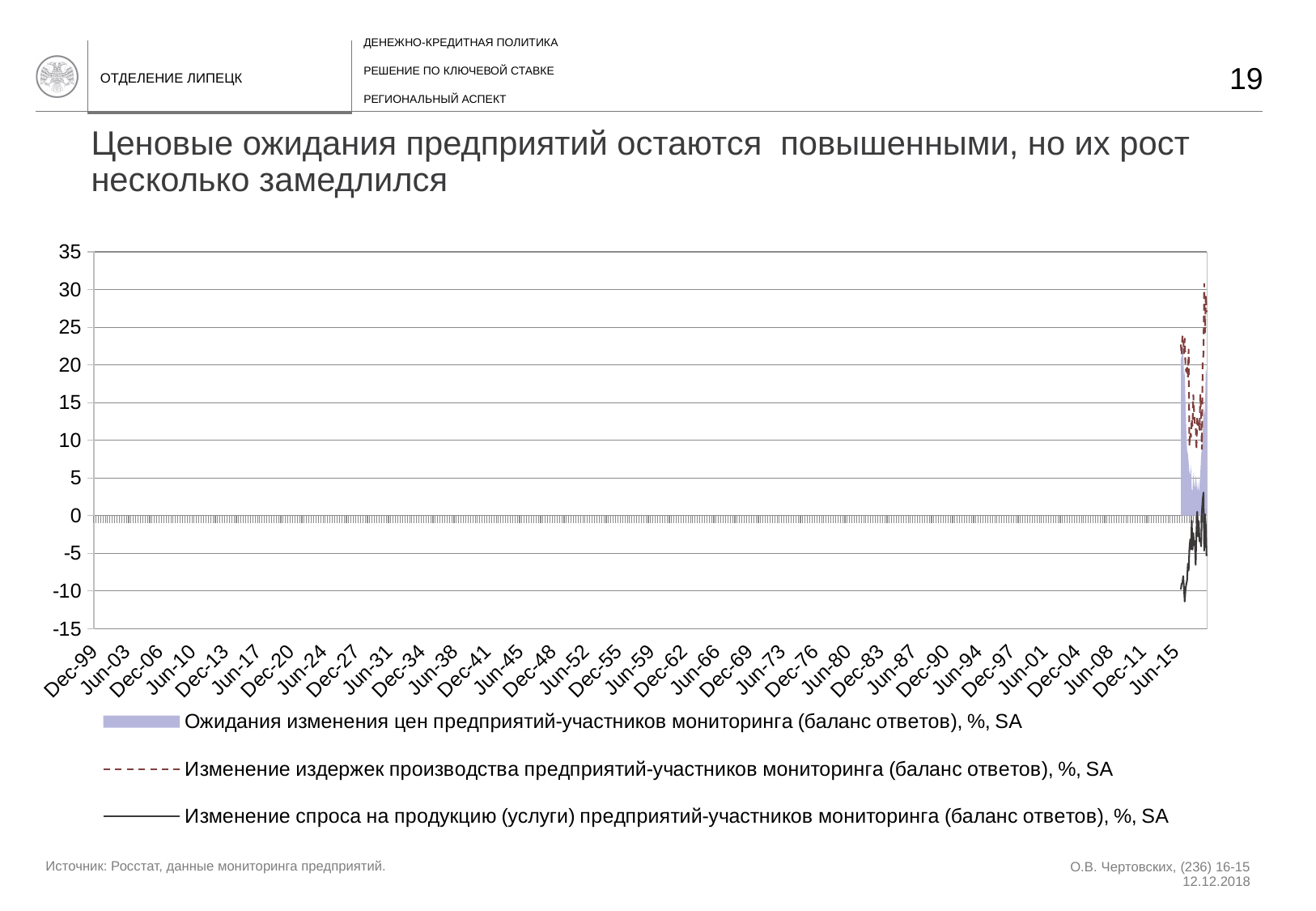
What is the first label shown on the horizontal axis of the chart? Dec-99 What is the lowest value shown on the vertical axis of the chart? -15 Which series reaches the lowest value on the chart? Изменение спроса на продукцию (услуги) предприятий-участников мониторинга (баланс ответов), %, SA Is the peak value of the shaded series 'Ожидания изменения цен предприятий-участников мониторинга (баланс ответов), %, SA' greater or less than 15? greater What is the highest value shown on the vertical axis of the chart? 35 Which series reaches the highest value on the chart: the dashed 'Изменение издержек производства' series or the solid black 'Изменение спроса на продукцию (услуги)' series? Изменение издержек производства предприятий-участников мониторинга (баланс ответов), %, SA What kind of chart is shown on the slide? Combination area and line chart How many series does the chart legend list? 3 Is the lowest value of the solid black series 'Изменение спроса на продукцию (услуги) предприятий-участников мониторинга (баланс ответов), %, SA' greater or less than -5? less Is the peak value of the dashed series 'Изменение издержек производства предприятий-участников мониторинга (баланс ответов), %, SA' greater or less than 25? greater